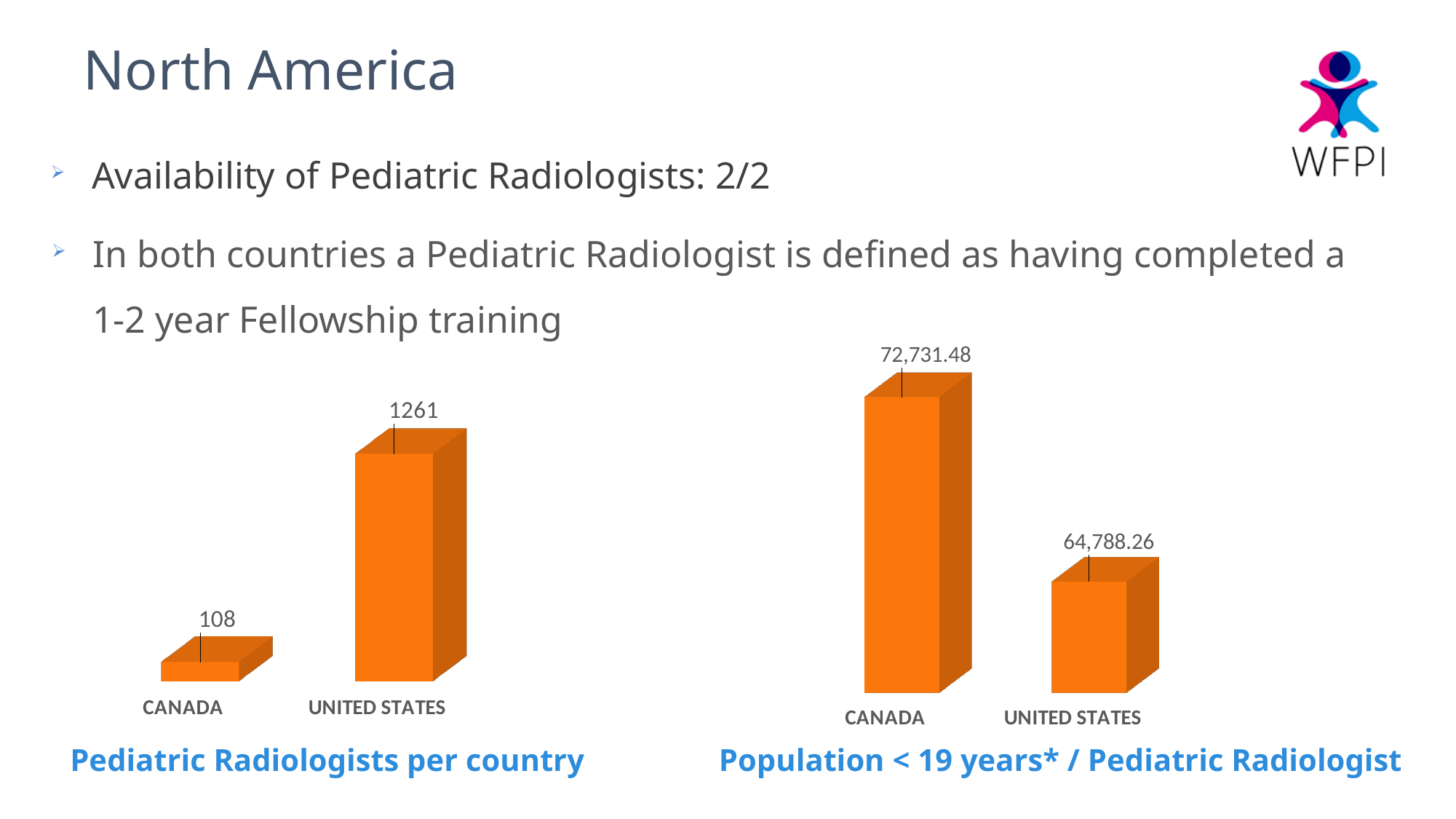
In the 'Population < 19 years* / Pediatric Radiologist' chart, which country has the lowest value? United States In the 'Pediatric Radiologists per country' chart, what is the difference between the United States and Canada values? 1153 In the 'Population < 19 years* / Pediatric Radiologist' chart, what is the value for Canada? 72,731.48 In the 'Population < 19 years* / Pediatric Radiologist' chart, what is the difference between the Canada and United States values? 7,943.22 In the 'Pediatric Radiologists per country' chart, what is the value for United States? 1261 In the 'Population < 19 years* / Pediatric Radiologist' chart, which is larger, the value for Canada or the value for United States? Canada What kind of chart is the 'Population < 19 years* / Pediatric Radiologist' chart? Bar chart What colour are the bars in the 'Pediatric Radiologists per country' chart? Orange How many countries are shown in the 'Pediatric Radiologists per country' chart? 2 In the 'Population < 19 years* / Pediatric Radiologist' chart, what is the value for United States? 64,788.26 In the 'Pediatric Radiologists per country' chart, what is the value for Canada? 108 In the 'Pediatric Radiologists per country' chart, which country has the highest value? United States